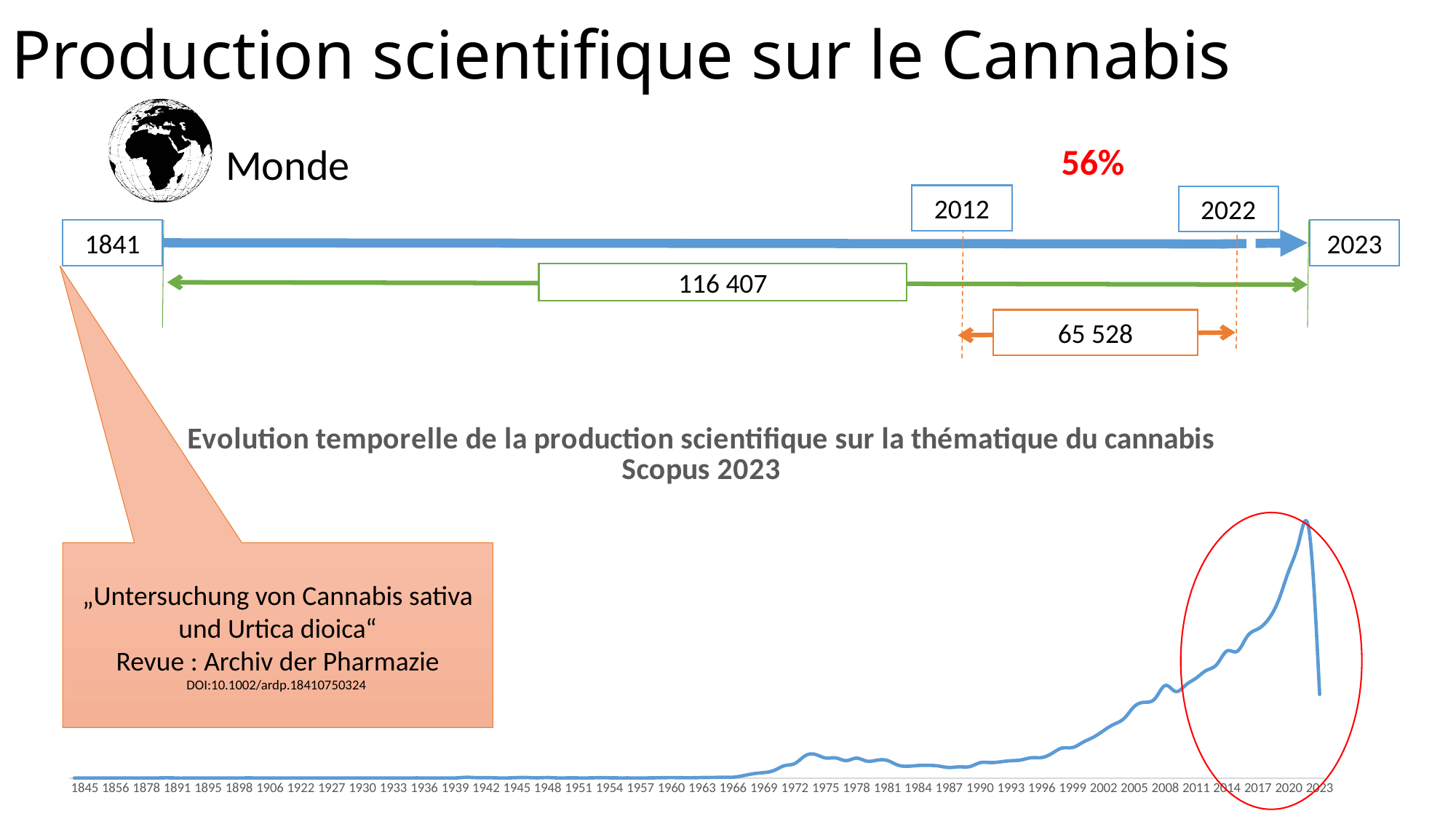
In the line chart, do the values generally rise or fall between 1966 and 2020? rise What kind of chart is shown at the bottom of the slide? line chart In the line chart, between which two x-axis labels does the line reach its highest point? 2020 and 2023 In the line chart, is the value higher in 1975 or in 2005? 2005 What is the title of the chart at the bottom of the slide? Evolution temporelle de la production scientifique sur la thématique du cannabis Scopus 2023 What is the first year label on the x axis of the line chart? 1845 In the line chart, is the value higher in 2020 or in 1960? 2020 In the line chart, does the line rise or fall after reaching its peak, towards 2023? fall